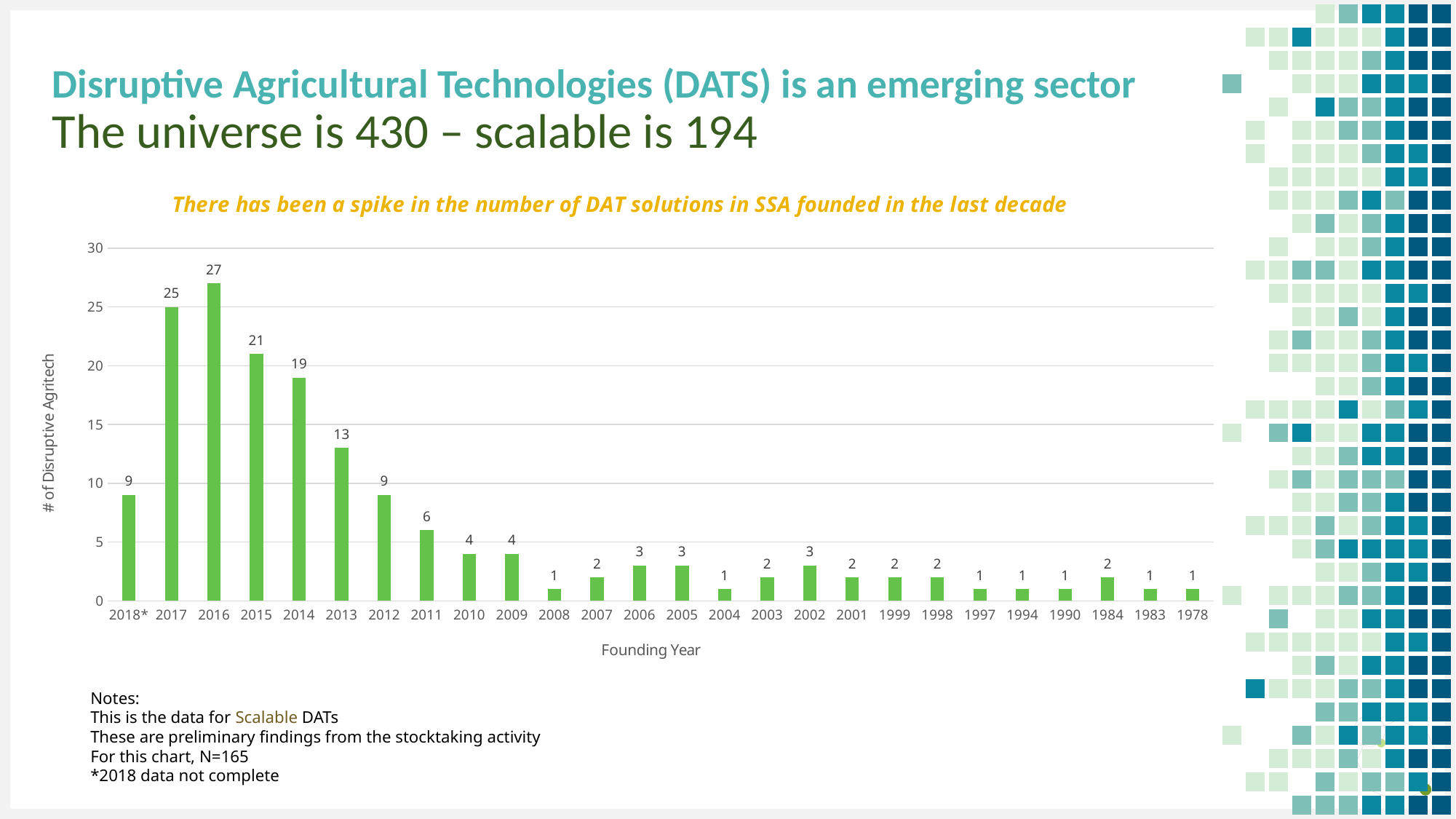
How many founding years are shown on the x axis? 26 Moving left to right along the x axis from 2018* to 1978, do the values generally rise or fall? fall What is the difference between the values for 2017 and 2015? 4 What is the value for founding year 2013? 13 What is the value for founding year 2011? 6 What is the value for founding year 1984? 2 How many Disruptive Agritech solutions were founded in 2016? 27 Which founding year has the highest number of Disruptive Agritech solutions? 2016 What kind of chart is shown on the slide? bar chart What is the difference between the values for 2016 and 2014? 8 Which founding year has a larger value, 2012 or 2010? 2012 Is the value for 2014 greater or less than 20? less